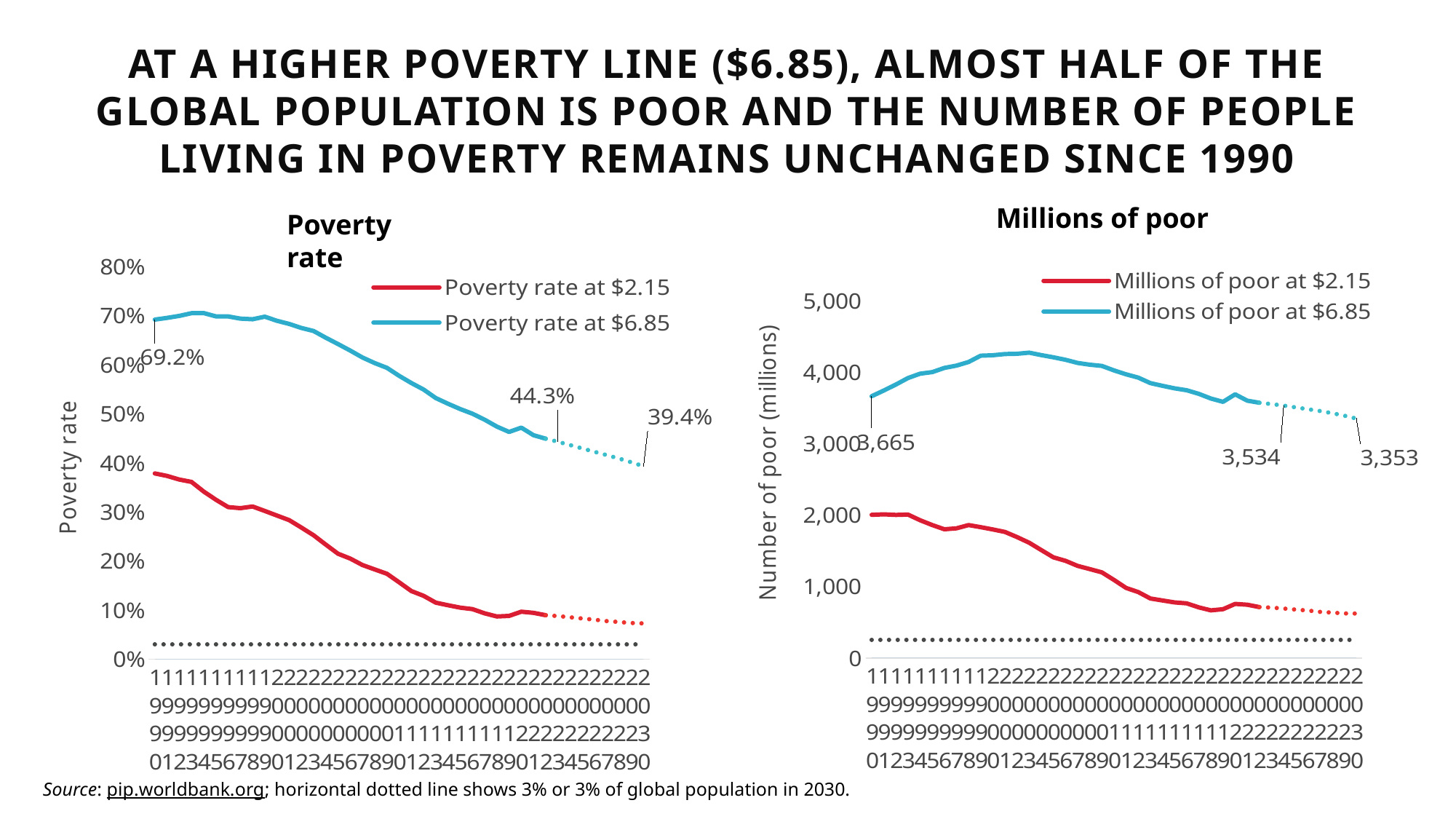
What kind of chart is the "Poverty rate" chart on the left? line chart In the "Millions of poor" chart, what is the difference between the labelled values 3,665 and 3,534 for the number of poor at $6.85? 131 In the "Poverty rate" chart, by how many percentage points does the labelled poverty rate at $6.85 fall from 69.2% in 1990 to 39.4% in 2030? 29.8 percentage points In the "Poverty rate" chart, what is the labelled value of the poverty rate at $6.85 where the solid line ends and the dotted projection begins? 44.3% In the "Poverty rate" chart, what is the labelled value of the poverty rate at $6.85 in 1990? 69.2% In the "Poverty rate" chart, what is the labelled value at the end of the dotted projection of the poverty rate at $6.85 in 2030? 39.4% In the "Poverty rate" chart, which series is shown in blue? Poverty rate at $6.85 How many series does the legend of the "Millions of poor" chart list? 2 In the "Poverty rate" chart, does the poverty rate at $2.15 rise or fall from 1990 to 2030? fall In the "Millions of poor" chart, is the number of poor at $2.15 in 1990 greater or less than 1,000? greater In the "Millions of poor" chart, what is the labelled number of poor at $6.85 in 1990? 3,665 In the "Millions of poor" chart, what is the labelled projected number of poor at $6.85 in 2030? 3,353